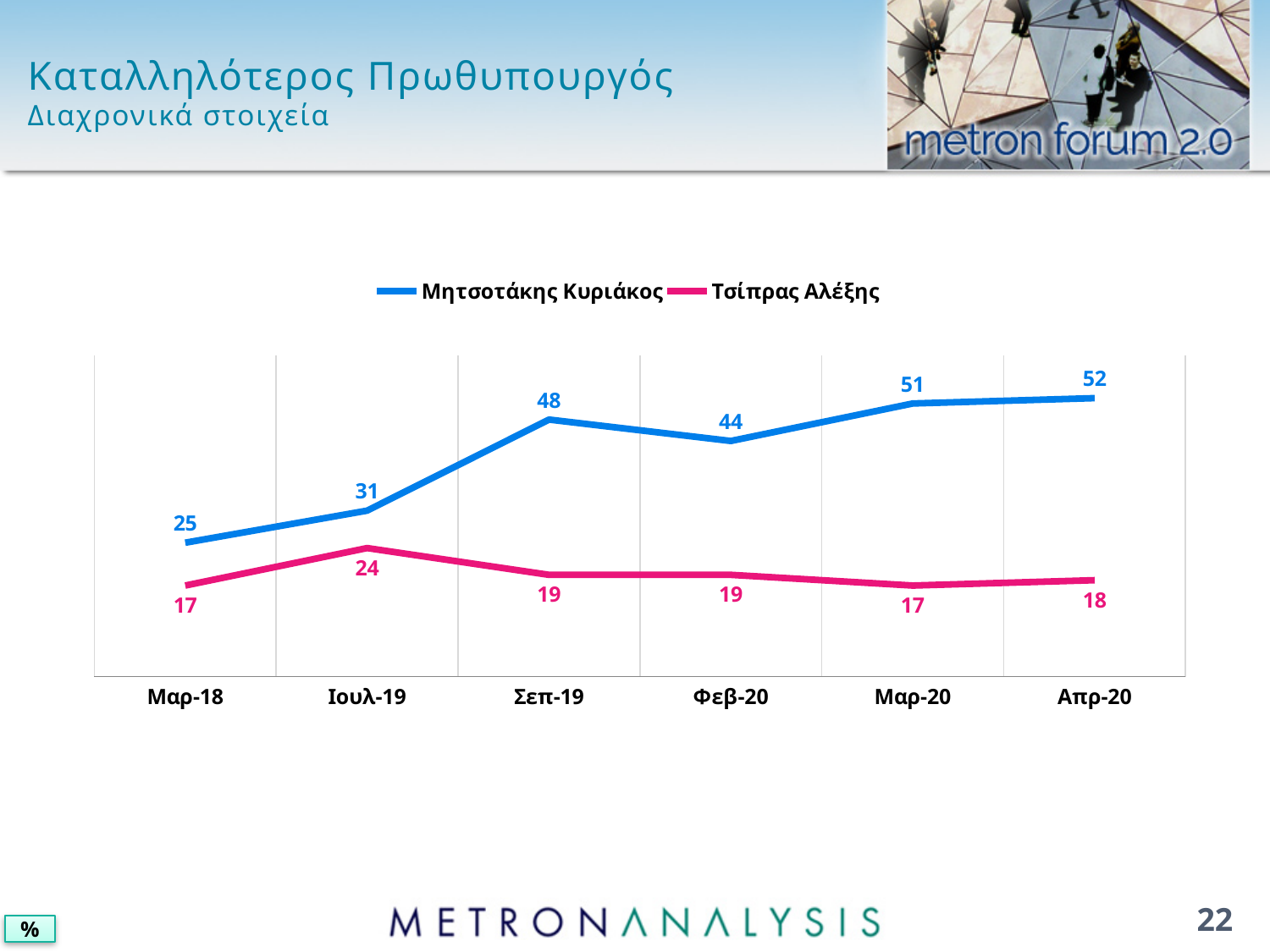
In which period does Μητσοτάκης Κυριάκος have his lowest value? Μαρ-18 What kind of chart is shown on the slide? Line chart What is the difference between Μητσοτάκης Κυριάκος and Τσίπρας Αλέξης in Απρ-20? 34 What is the value for Μητσοτάκης Κυριάκος in Μαρ-18? 25 How many series does the legend list? 2 In which period does Μητσοτάκης Κυριάκος reach his highest value? Απρ-20 Does the value for Μητσοτάκης Κυριάκος rise or fall from Μαρ-18 to Σεπ-19? Rise What is the value for Μητσοτάκης Κυριάκος in Σεπ-19? 48 How many time periods are shown on the x axis? 6 In which period does Τσίπρας Αλέξης reach his highest value? Ιουλ-19 Which series has the higher value in Φεβ-20, Μητσοτάκης Κυριάκος or Τσίπρας Αλέξης? Μητσοτάκης Κυριάκος What is the value for Τσίπρας Αλέξης in Ιουλ-19? 24